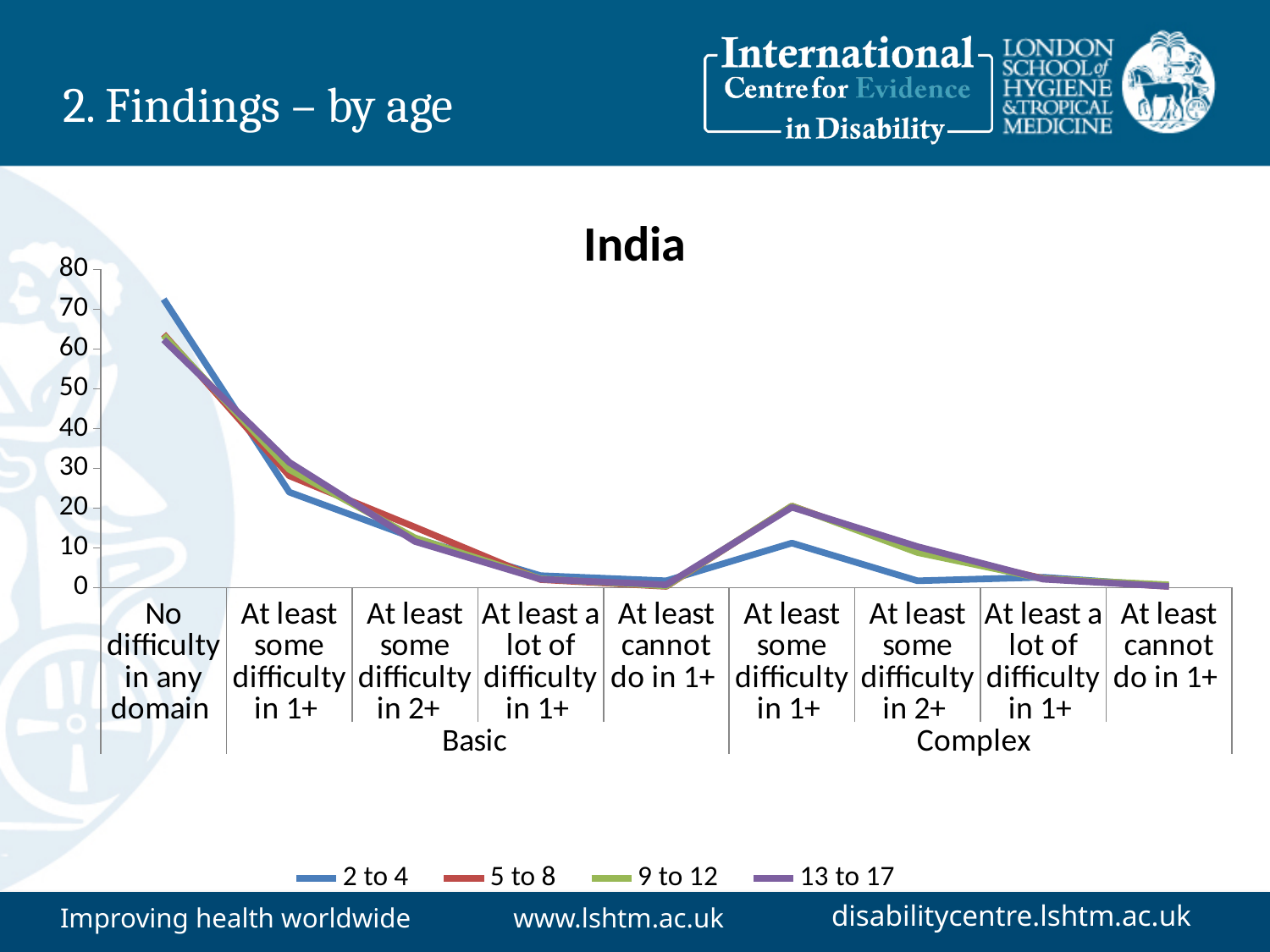
At 'No difficulty in any domain', which series has the larger value, 2 to 4 or 13 to 17? 2 to 4 Is the value for the 13 to 17 series at 'No difficulty in any domain' greater or less than 50? greater What kind of chart is shown on the slide? line chart How many categories are shown along the x axis? 9 Is the value for the 13 to 17 series at 'At least some difficulty in 1+' under Complex greater or less than 10? greater For the 2 to 4 series, which category has the highest value? No difficulty in any domain What is the title of the chart? India Across the Basic categories from 'No difficulty in any domain' to 'At least cannot do in 1+', do the values for the 2 to 4 series rise or fall? fall Is the value for the 2 to 4 series at 'No difficulty in any domain' greater or less than 60? greater Which age group is shown by the blue line in the legend? 2 to 4 How many series does the legend list? 4